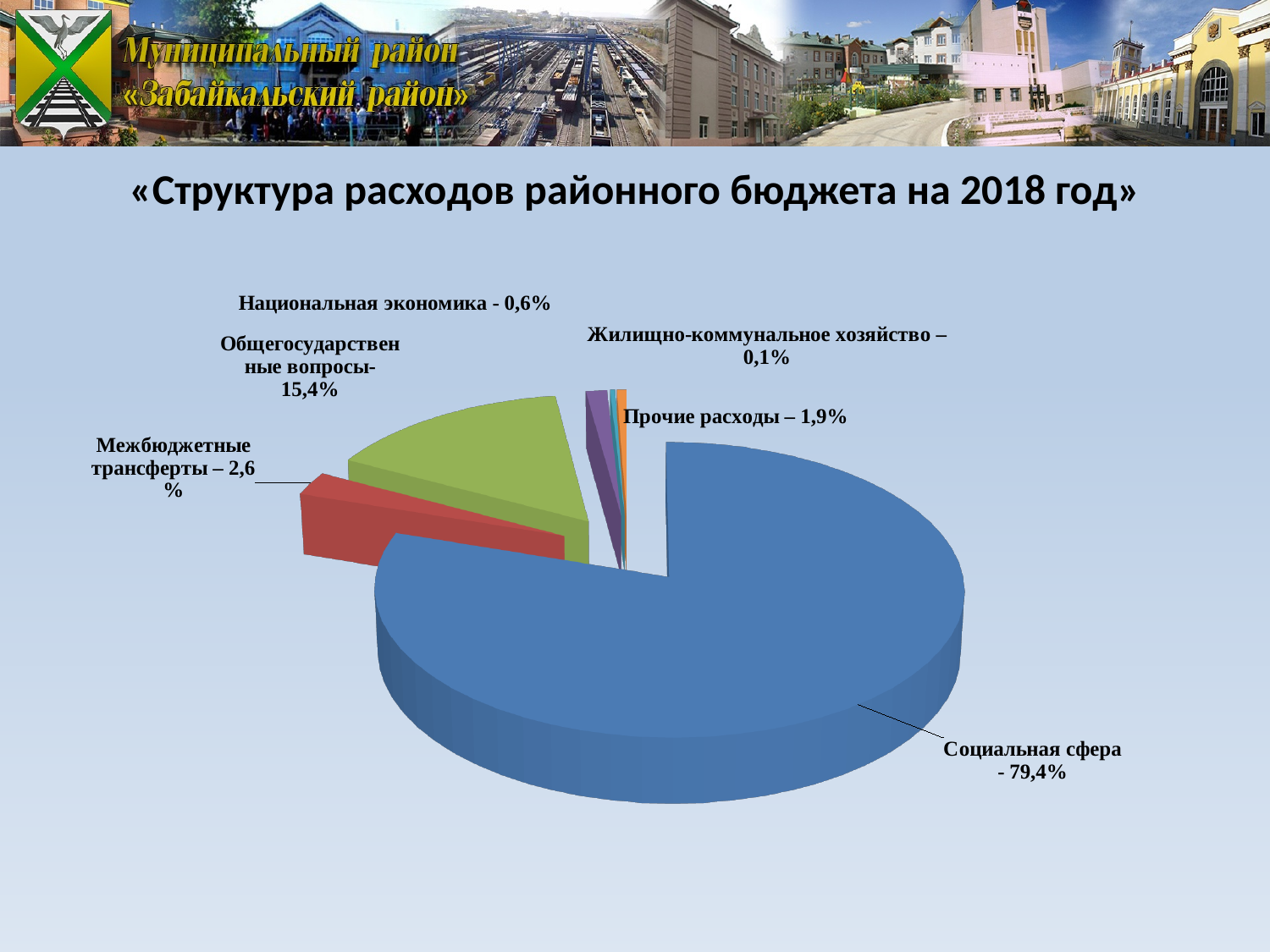
What is the title of the chart on the slide? «Структура расходов районного бюджета на 2018 год» What share is shown for Межбюджетные трансферты? 2,6% What share is shown for Прочие расходы? 1,9% What kind of chart is shown on the slide? pie chart Which category has the largest share of the pie? Социальная сфера Which category has the smallest share of the pie? Жилищно-коммунальное хозяйство What share is shown for Общегосударственные вопросы? 15,4% What is the difference in percentage points between Социальная сфера and Общегосударственные вопросы? 64 percentage points How many categories are shown in the pie chart? 6 Which is larger, the share for Межбюджетные трансферты or for Прочие расходы? Межбюджетные трансферты What share of the budget expenditure goes to Социальная сфера? 79,4% What share is shown for Жилищно-коммунальное хозяйство? 0,1%